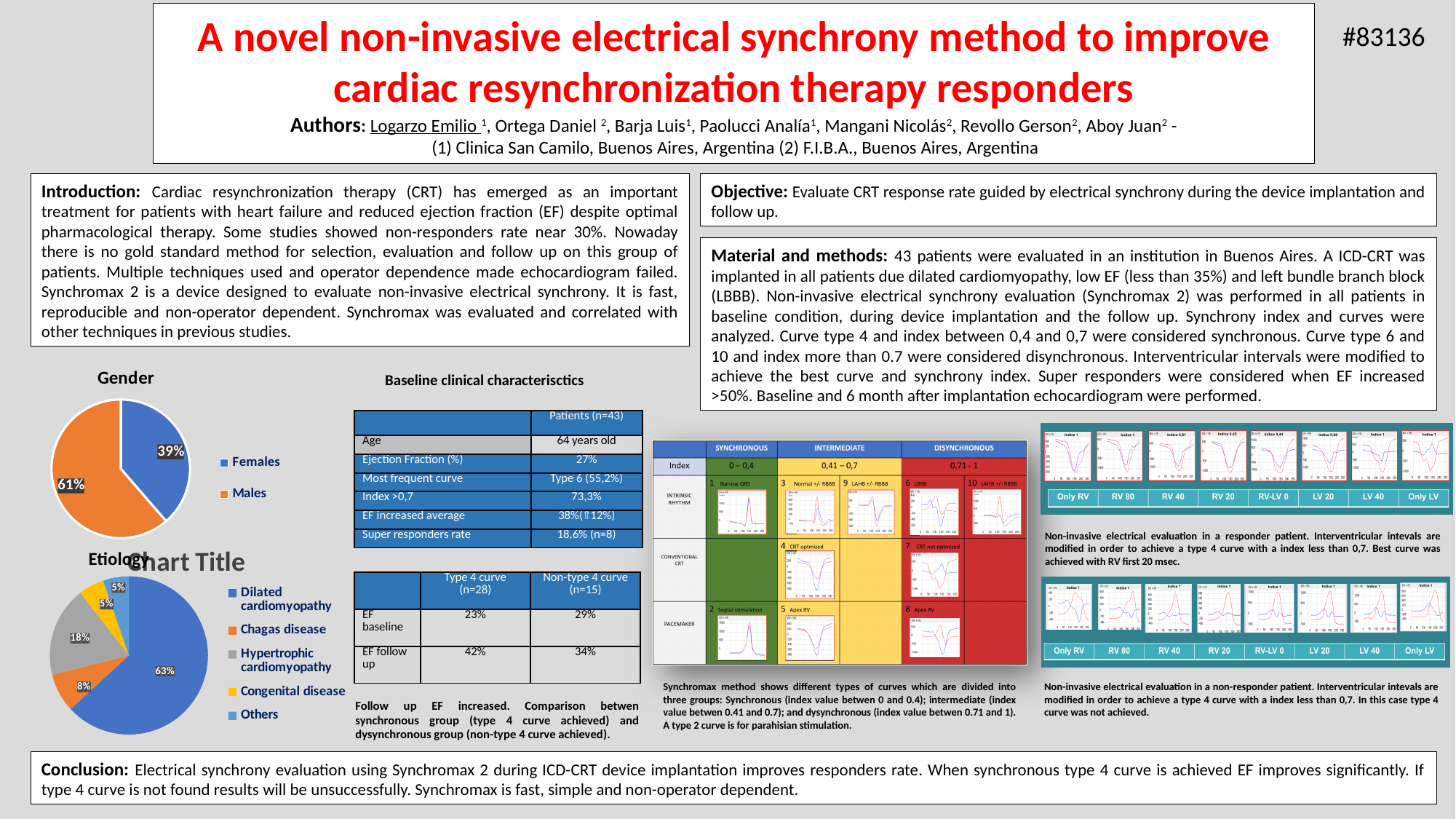
How many categories does the Gender pie chart show? 2 In the Etiology pie chart, what share is Chagas disease? 8% How many categories does the Etiology pie chart legend list? 5 In the Etiology pie chart, what share is Hypertrophic cardiomyopathy? 18% In the Gender pie chart, what share of patients are Females? 39% What kind of chart is the Gender chart? Pie chart In the Gender pie chart, what is the difference between the Males and Females shares? 22% In the Etiology pie chart, which category has the largest share? Dilated cardiomyopathy In the Etiology pie chart, what share is Dilated cardiomyopathy? 63% In the Etiology pie chart, which is larger: Hypertrophic cardiomyopathy or Chagas disease? Hypertrophic cardiomyopathy In the Gender pie chart, which category has the larger share? Males In the Gender pie chart, what share of patients are Males? 61%